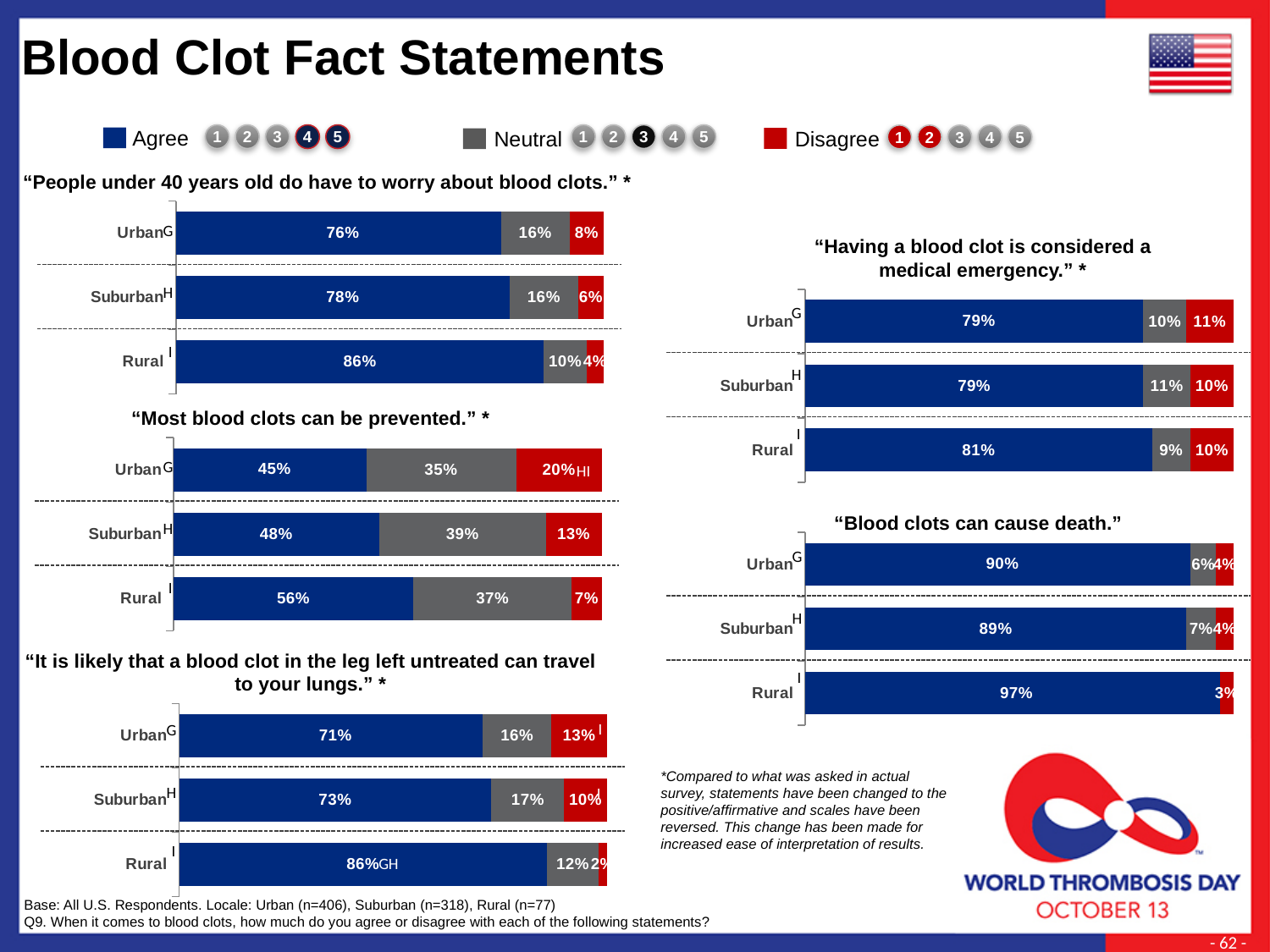
In the chart "Most blood clots can be prevented," what is the difference between the Rural and Urban Agree percentages? 11% In the chart "Having a blood clot is considered a medical emergency," what percentage of Rural respondents agree? 81% In the chart "Most blood clots can be prevented," what percentage of Urban respondents disagree? 20% In the chart "People under 40 years old do have to worry about blood clots," which locale has the lowest Agree percentage? Urban In the chart "People under 40 years old do have to worry about blood clots," what percentage of Rural respondents agree? 86% In the chart "It is likely that a blood clot in the leg left untreated can travel to your lungs," is the Urban Disagree percentage larger or smaller than the Suburban Disagree percentage? larger How many locale categories are shown in the chart "Blood clots can cause death"? 3 In the chart "Having a blood clot is considered a medical emergency," what percentage of Urban respondents disagree? 11% How many series does the legend at the top of the slide list? 3 In the chart "Most blood clots can be prevented," which locale has the highest Agree percentage? Rural In the chart "It is likely that a blood clot in the leg left untreated can travel to your lungs," what percentage of Suburban respondents are neutral? 17% In the chart "Blood clots can cause death," what percentage of Rural respondents agree? 97%